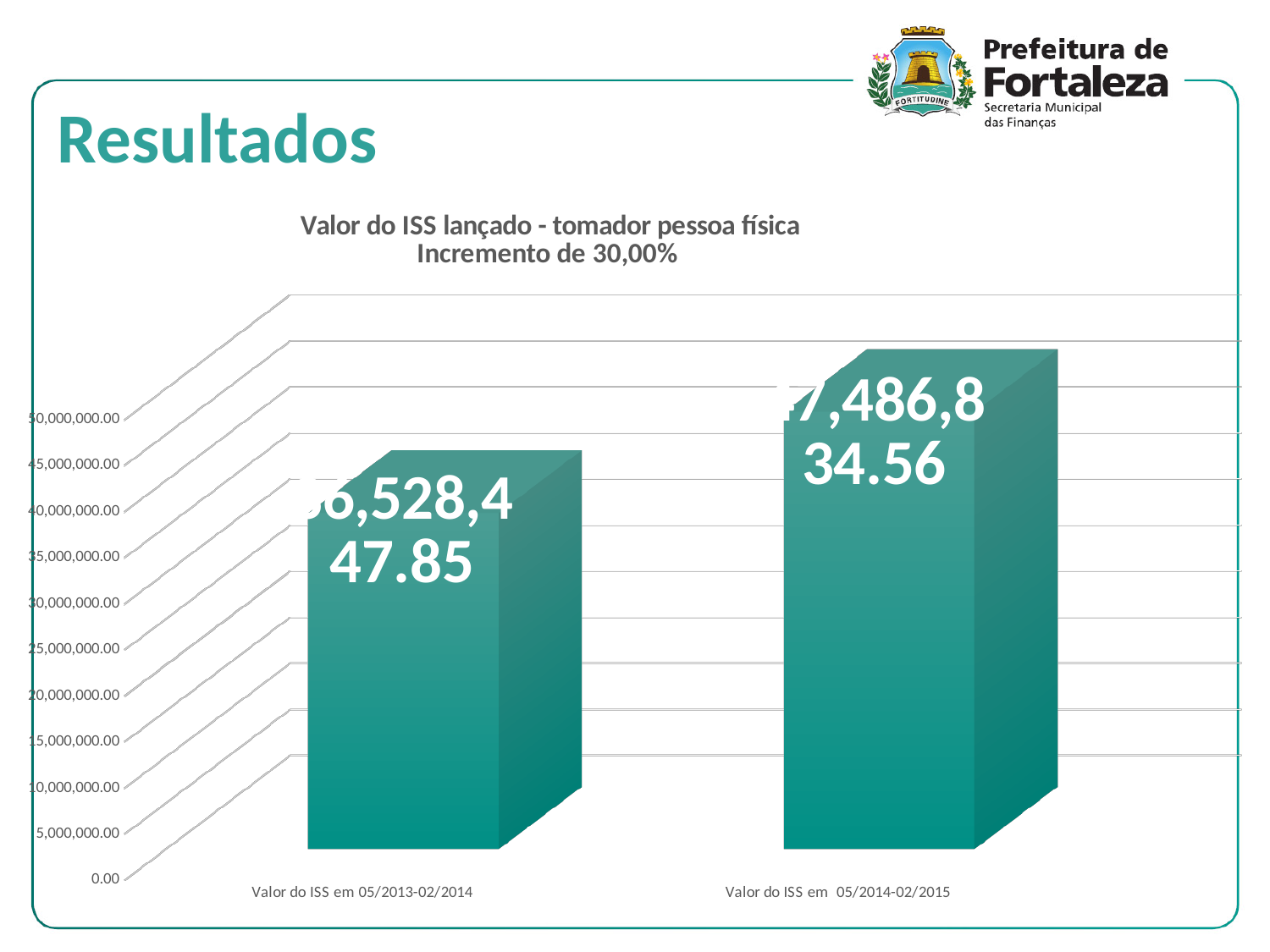
Is the value for Valor do ISS em 05/2013-02/2014 greater or less than 30,000,000.00? greater Is the value for Valor do ISS em 05/2013-02/2014 greater or less than 45,000,000.00? less Do the values rise or fall from the first period to the second period? rise What percentage increase does the chart title state? 30,00% Which category has the highest value? Valor do ISS em 05/2014-02/2015 Which is larger: the value for 05/2013-02/2014 or the value for 05/2014-02/2015? 05/2014-02/2015 Is the value for Valor do ISS em 05/2014-02/2015 greater or less than 40,000,000.00? greater How many bars does the chart show? 2 What is the first line of the chart title? Valor do ISS lançado - tomador pessoa física Which category has the lowest value? Valor do ISS em 05/2013-02/2014 What kind of chart is shown on the slide? bar chart